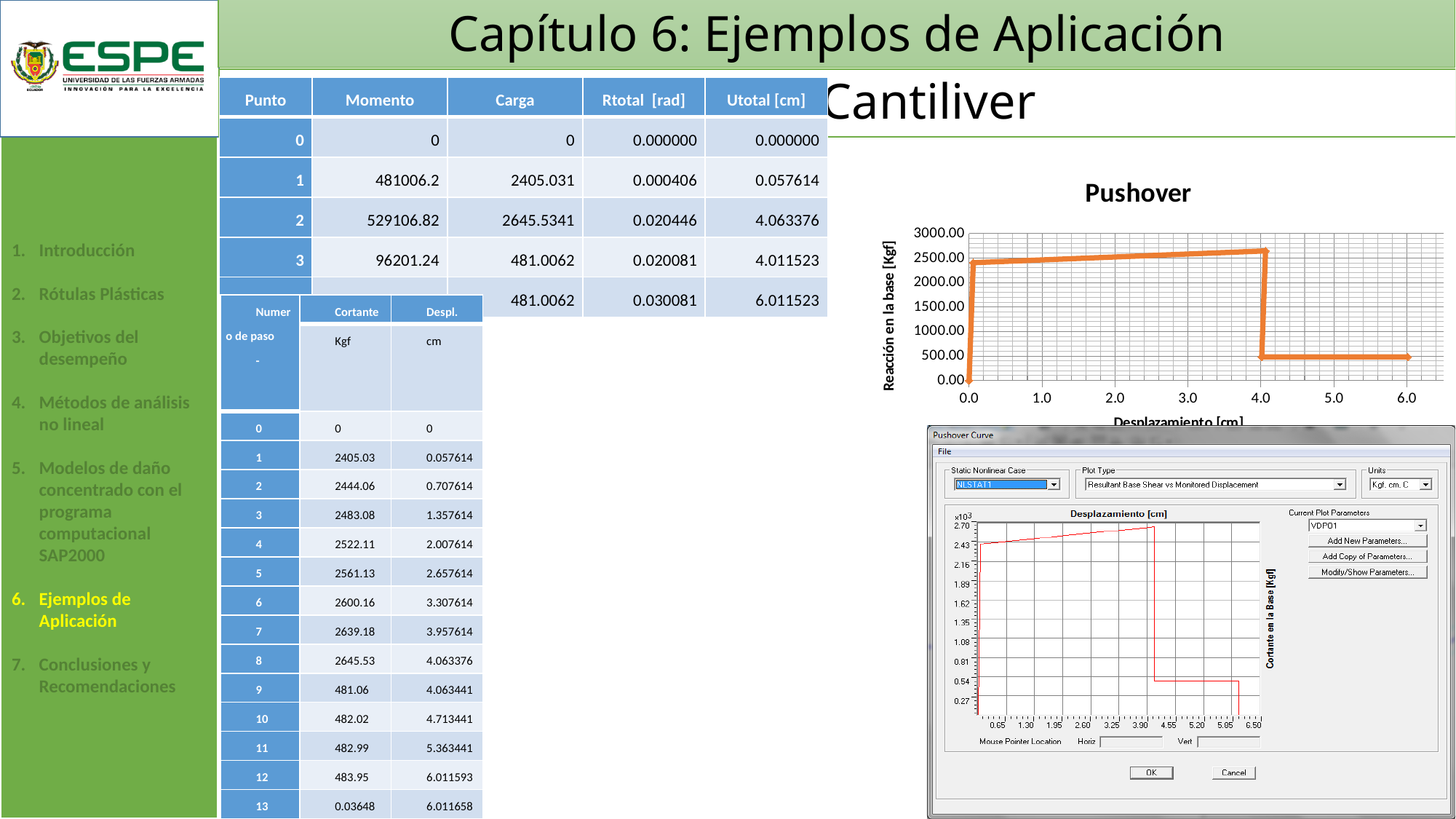
In the 'Pushover' chart, is the value at a displacement of 3.0 cm greater or less than 3000? less In the 'Pushover' chart, does the base reaction rise or fall as displacement goes from 0.0 to 1.0 cm? rise In the 'Pushover' chart, what is the highest tick value shown on the vertical axis? 3000.00 In the 'Pushover' chart, is the value at a displacement of 1.0 cm greater or less than 1500? greater In the 'Pushover' chart, what is the largest displacement value shown on the horizontal axis? 6.0 What kind of chart is the 'Pushover' chart on the slide? line chart In the 'Pushover' chart, what is the label of the vertical axis? Reacción en la base [Kgf] In the 'Pushover' chart, is the value at a displacement of 5.0 cm greater or less than 1000? less What is the title of the chart in the upper right of the slide? Pushover In the 'Pushover' chart, is the value at a displacement of 3.0 cm larger or smaller than the value at 5.0 cm? larger